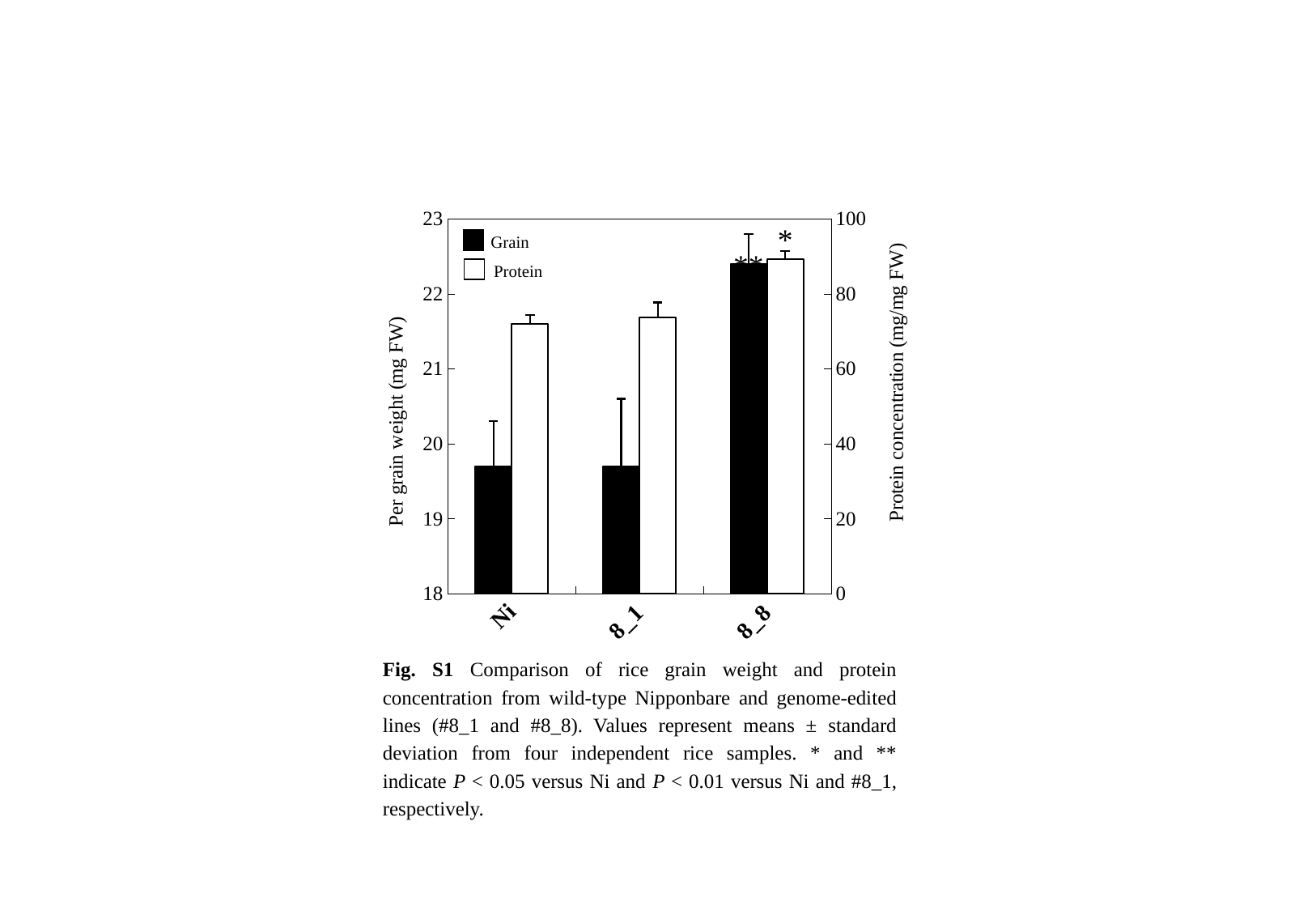
How many series does the chart's legend list? 2 Is the Grain value for Ni greater or less than 20? less Which has the larger Grain value, Ni or 8_8? 8_8 Is the Protein value for 8_8 greater or less than 80? greater How many categories are shown on the x axis of the chart? 3 What kind of chart is shown on the slide? bar chart Which category has the highest Grain value? 8_8 Which category has the highest Protein value? 8_8 Which has the larger Protein value, 8_1 or 8_8? 8_8 Is the Protein value for Ni greater or less than 60? greater What is the label of the left y axis of the chart? Per grain weight (mg FW)